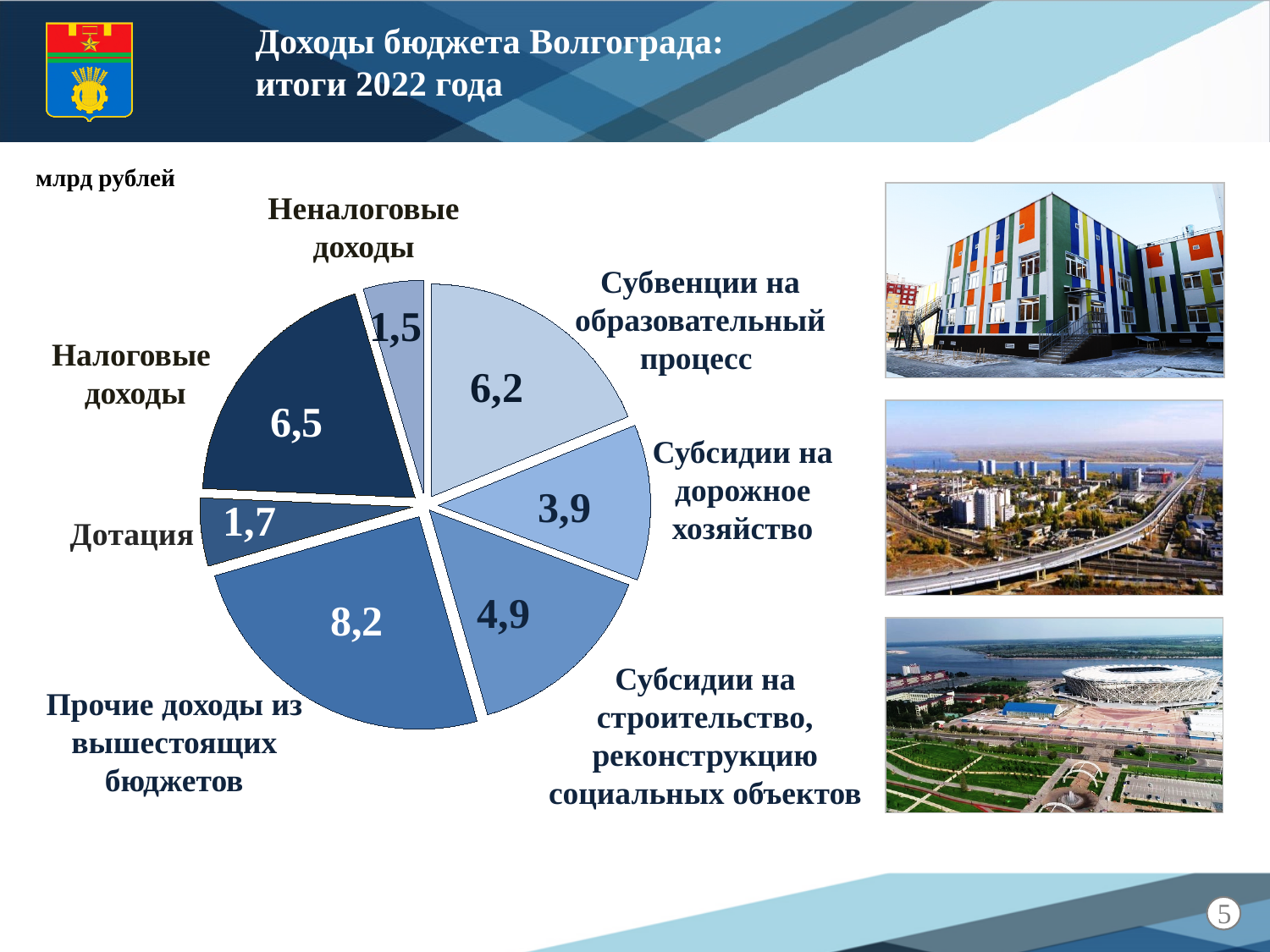
What is the sum of all slices in the pie chart? 32,9 What is the value for Дотация? 1,7 Which is larger: Налоговые доходы or Субвенции на образовательный процесс? Налоговые доходы What kind of chart is shown on the slide? pie chart What is the difference between Прочие доходы из вышестоящих бюджетов and Субсидии на строительство, реконструкцию социальных объектов? 3,3 What is the value for Налоговые доходы? 6,5 Which category has the largest slice of the pie? Прочие доходы из вышестоящих бюджетов In what units are the values on the chart given? млрд рублей What is the value for Субсидии на дорожное хозяйство? 3,9 What is the value for Субвенции на образовательный процесс? 6,2 How many slices does the pie chart have? 7 Which category has the smallest slice of the pie? Неналоговые доходы